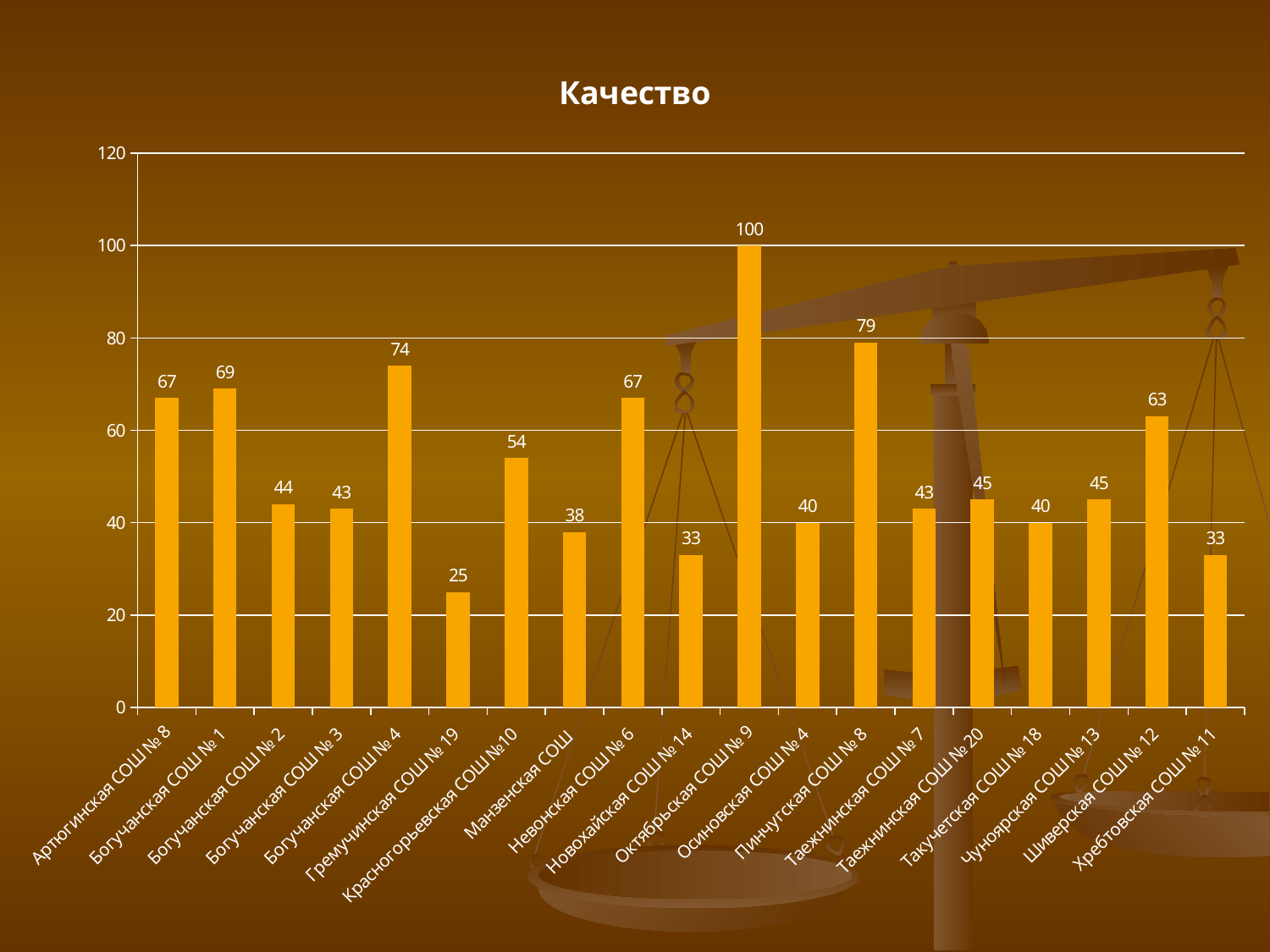
What is the value for Красногорьевская СОШ №10? 54 Which is larger, the value for Шиверская СОШ № 12 or the value for Хребтовская СОШ № 11? Шиверская СОШ № 12 Which school has the lowest value? Гремучинская СОШ № 19 What is the value for Пинчугская СОШ № 8? 79 How many schools are shown on the chart? 19 Which school has the highest value? Октябрьская СОШ № 9 What kind of chart is this? bar chart What is the value for Октябрьская СОШ № 9? 100 Is the value for Манзенская СОШ greater or less than 40? less What is the title of the chart? Качество What is the difference between the values for Богучанская СОШ № 4 and Богучанская СОШ № 2? 30 What is the value for Гремучинская СОШ № 19? 25